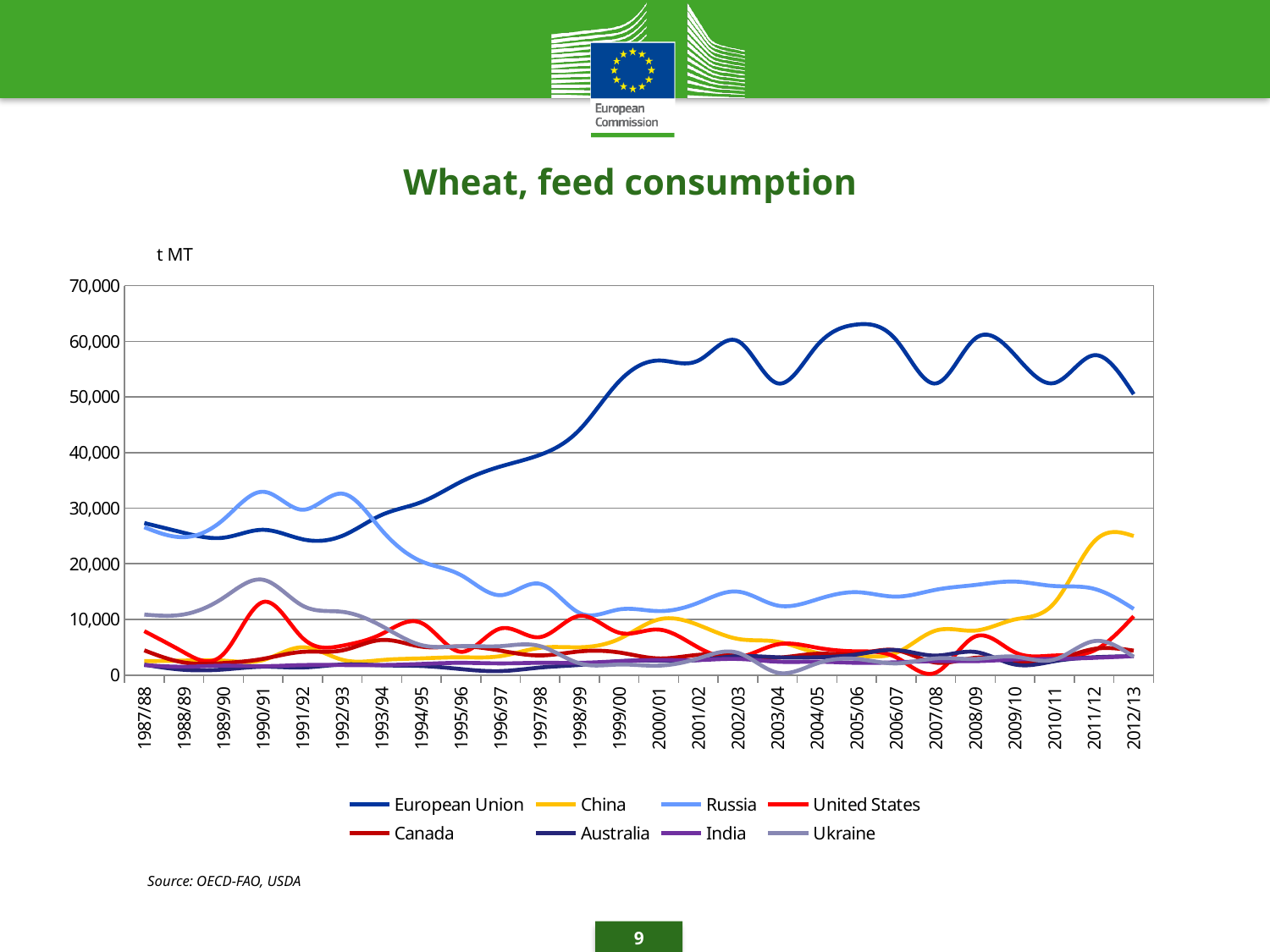
Which is larger in 2012/13, the value for China or the value for Russia? China How many series does the legend list? 8 What is the title of the chart? Wheat, feed consumption Does the European Union series overall rise or fall from 1987/88 to 2012/13? rise Is the value for the European Union in 1987/88 greater or less than 30,000? less Is the value for the European Union in 2005/06 greater or less than 60,000? greater Is the value for China in 2011/12 greater or less than 20,000? greater What kind of chart is shown on the slide? line chart Which series has the highest wheat feed consumption in 2012/13? European Union How many marketing years are shown along the x axis? 26 What unit is shown on the y axis of the chart? t MT